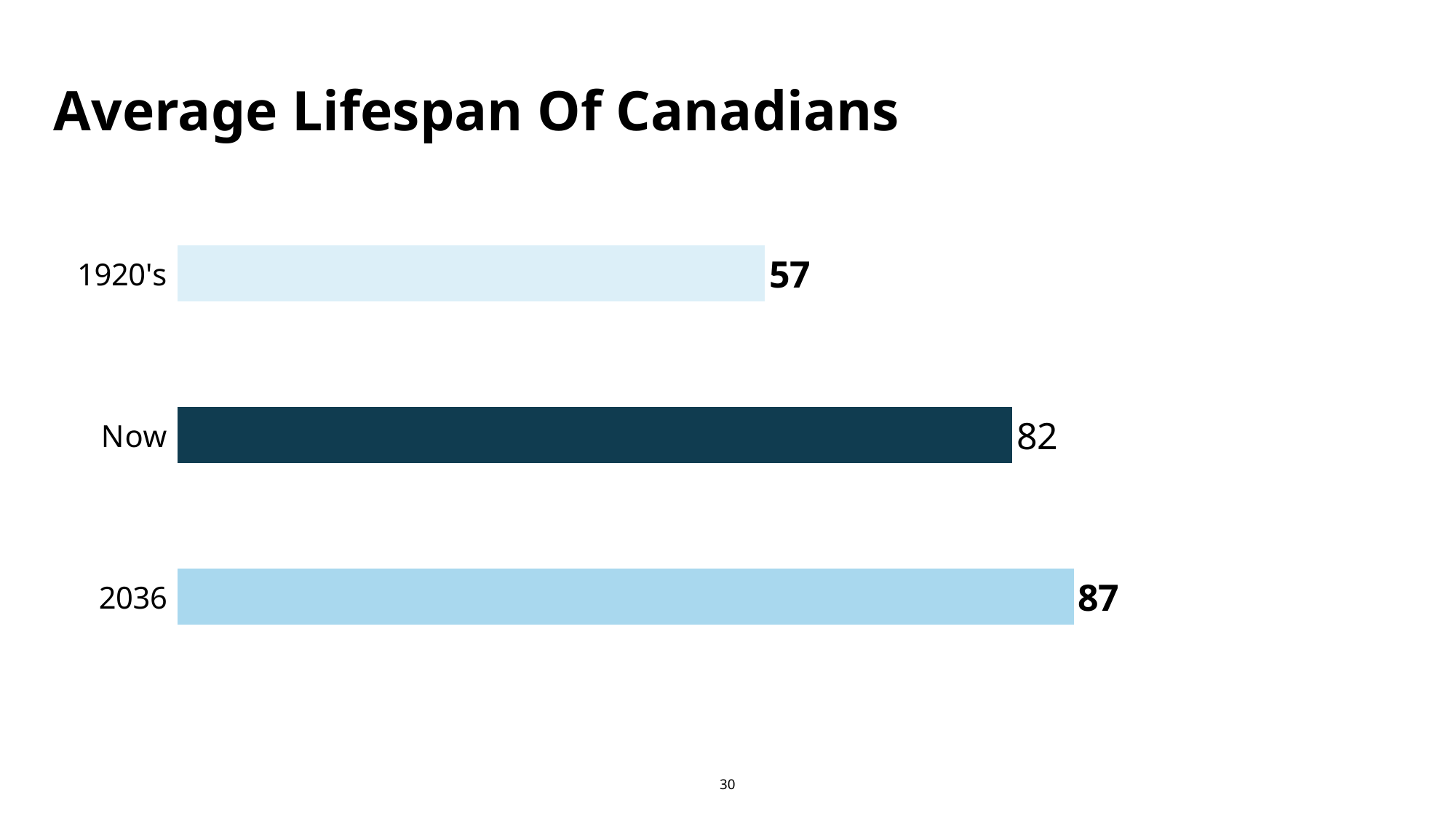
What kind of chart is shown on the slide? Bar chart What is the title of the chart? Average Lifespan Of Canadians Which category has the highest average lifespan? 2036 What is the average lifespan shown for 2036? 87 What is the difference between the average lifespan for Now and for the 1920's? 25 Which category has the lowest average lifespan? 1920's Which is larger, the average lifespan for Now or for the 1920's? Now What is the average lifespan shown for the 1920's? 57 What is the difference between the average lifespan for 2036 and for Now? 5 How many categories are shown in the chart? 3 What is the average lifespan shown for Now? 82 What is the difference between the average lifespan for 2036 and for the 1920's? 30